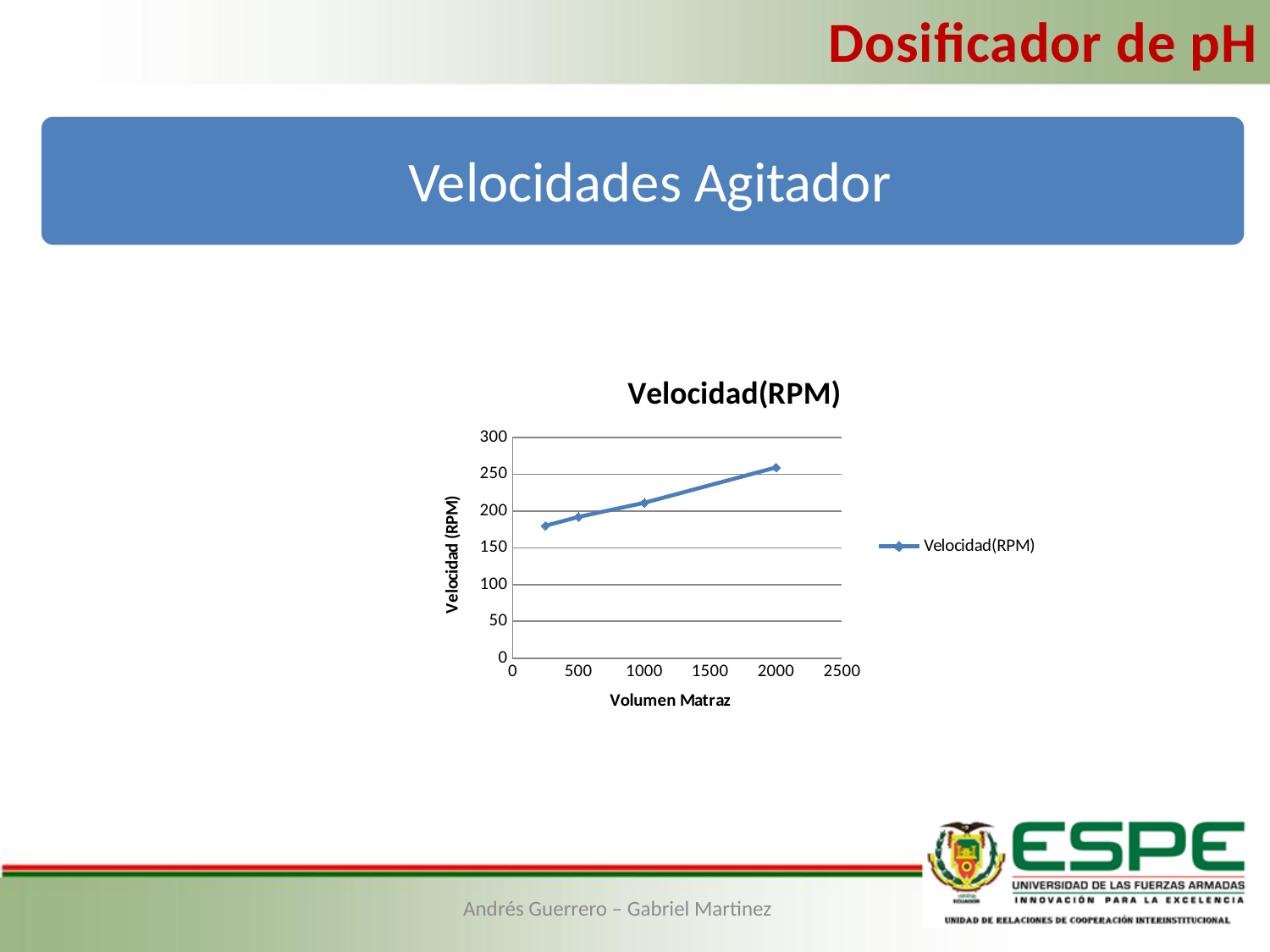
Do the values rise or fall as Volumen Matraz increases? rise Is the Velocidad (RPM) at Volumen Matraz 2000 greater or less than 200? greater Is the Velocidad (RPM) at Volumen Matraz 1000 greater or less than 200? greater Which is larger, the Velocidad (RPM) at Volumen Matraz 1000 or at 2000? 2000 How many series does the legend list? 1 Is the Velocidad (RPM) of the leftmost point greater or less than 200? less What is the label of the x axis of the chart? Volumen Matraz What kind of chart is shown on the slide? line chart How many data points are plotted on the line? 4 At which Volumen Matraz value is the Velocidad (RPM) highest? 2000 What is the title of the chart? Velocidad(RPM)